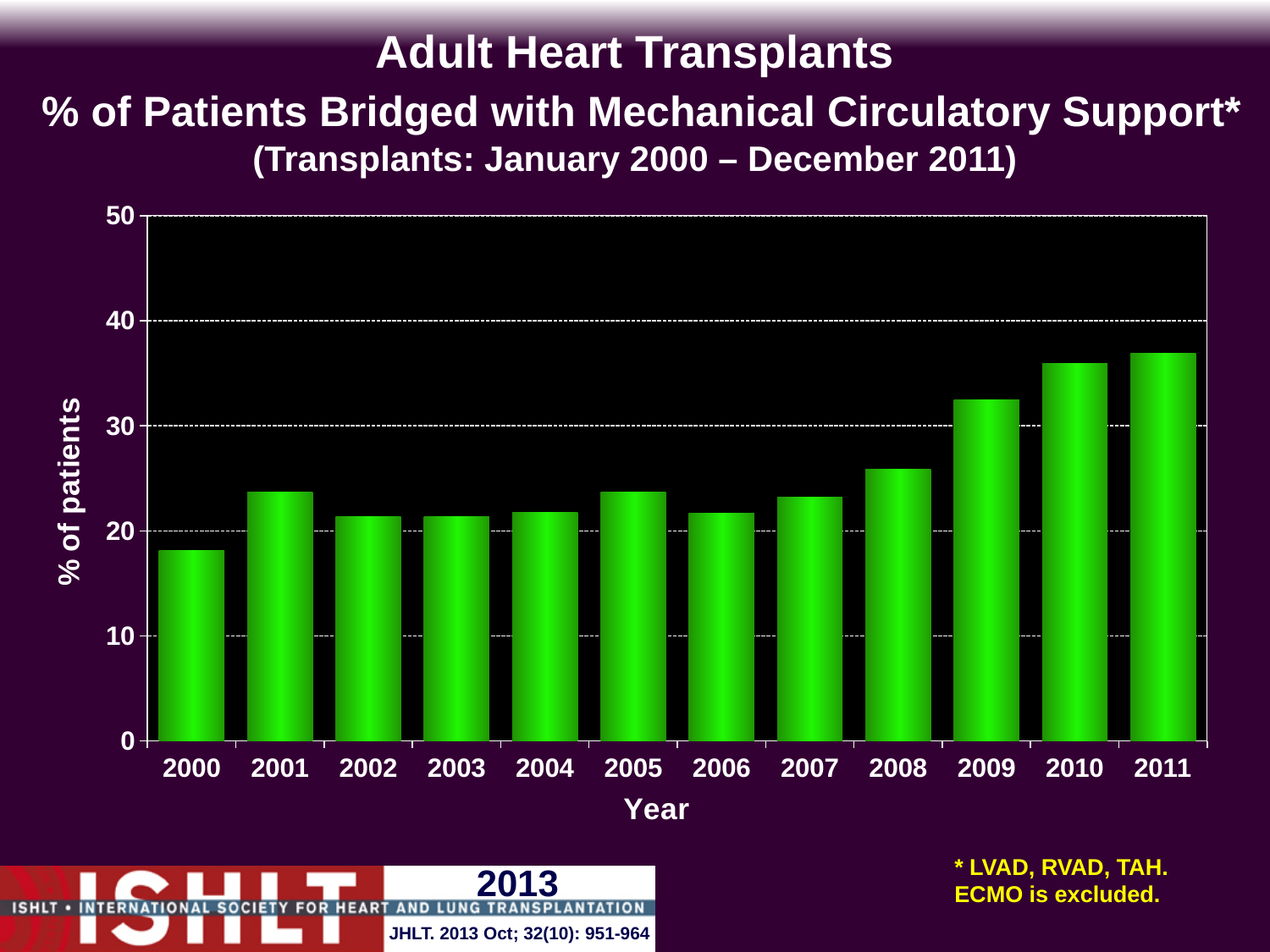
Is the value for 2008 greater or less than 30? less What kind of chart is shown on the slide? bar chart How many years are plotted on the x axis of the chart? 12 Is the value for 2009 greater or less than 30? greater Is the value for 2000 greater or less than 20? less Which year has the highest % of patients bridged with mechanical circulatory support? 2011 Which year has the lowest % of patients bridged with mechanical circulatory support? 2000 Which year has the larger value, 2000 or 2001? 2001 What is the label of the y axis of the chart? % of patients Which year has the larger value, 2008 or 2009? 2009 Do the values generally rise or fall from 2007 to 2011? rise